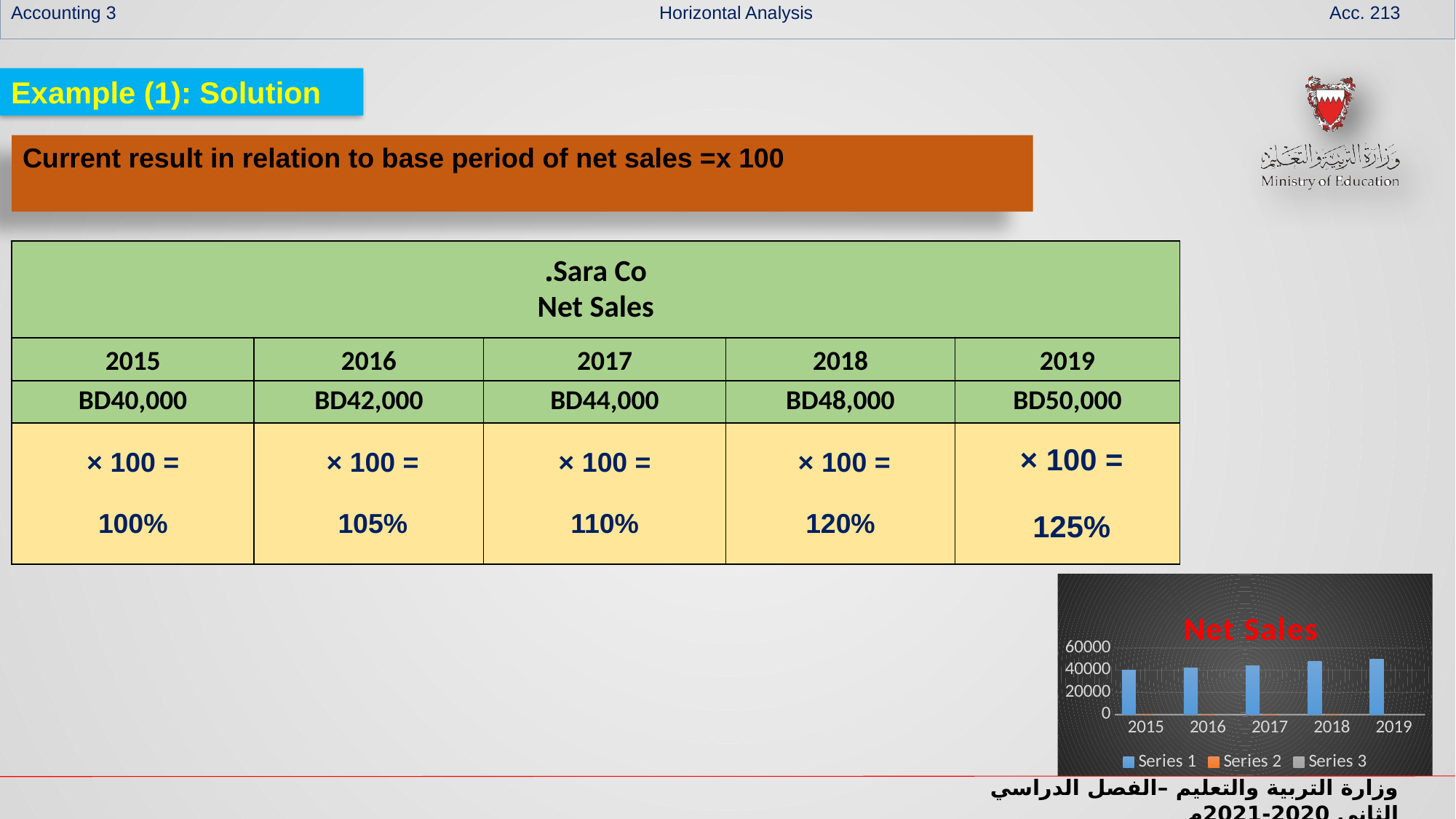
In the Net Sales chart, is the value for 2017 greater or less than 20000? greater How many series does the legend of the Net Sales chart list? 3 What is the title of the chart on the slide? Net Sales Do the bars in the Net Sales chart rise or fall from 2015 to 2019? rise In the Net Sales chart, is the bar for 2019 taller or shorter than the bar for 2015? taller In the Net Sales chart, is the value for 2015 greater or less than 60000? less What colour are the bars in the Net Sales chart? blue In the Net Sales chart, is the value for 2019 greater or less than 40000? greater How many years are shown on the x axis of the Net Sales chart? 5 Which year has the tallest bar in the Net Sales chart? 2019 Which year has the shortest bar in the Net Sales chart? 2015 What kind of chart is shown on the slide? bar chart